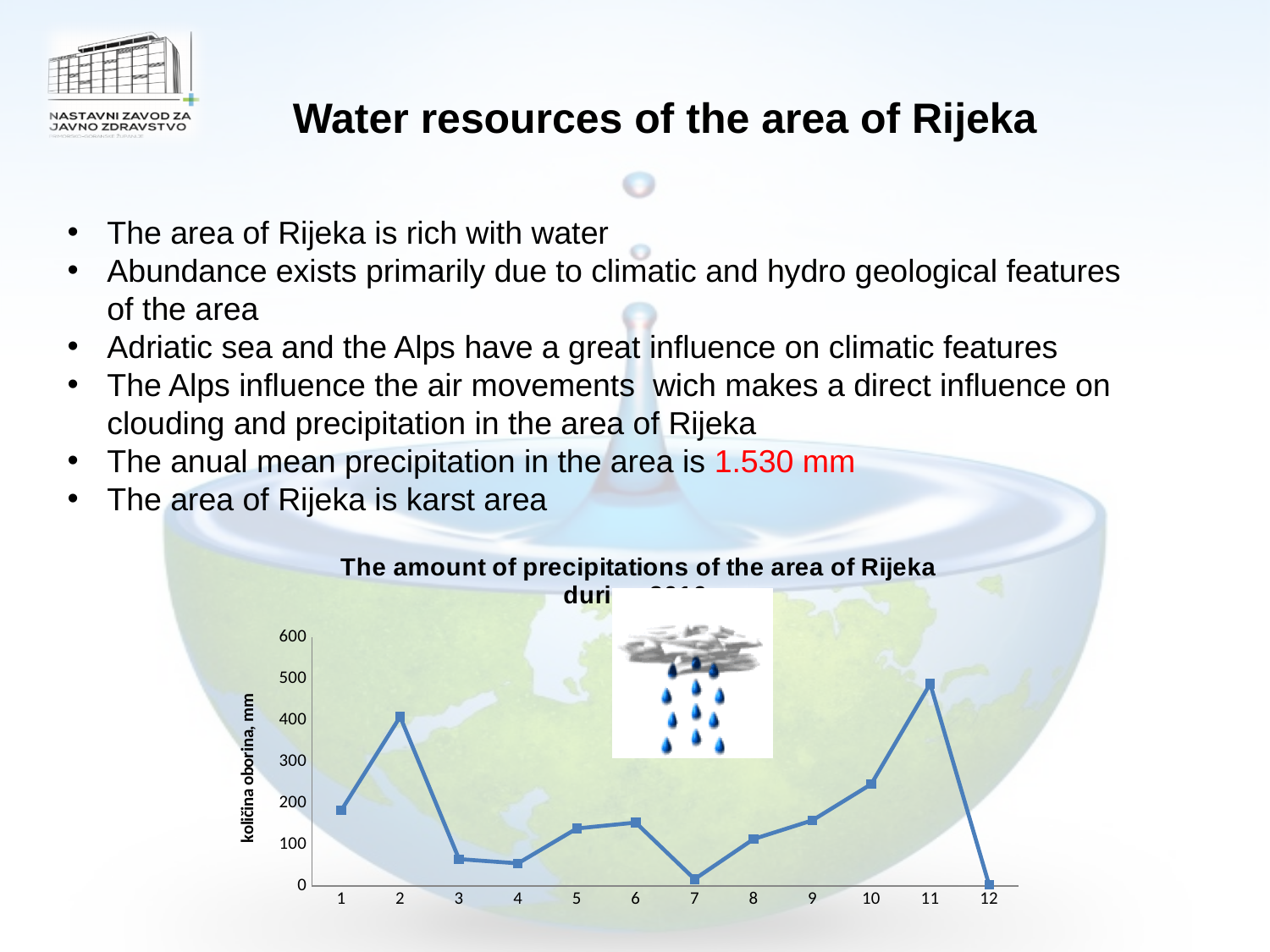
Which has the larger value, month 10 or month 1? month 10 Is the value for month 11 greater or less than 400? greater Is the value for month 2 greater or less than 300? greater How many data points are plotted on the chart? 12 Which month (x-axis category) has the lowest precipitation value? 12 What is the label on the vertical axis of the chart? količina oborina, mm Is the value for month 1 greater or less than 100? greater What kind of chart is shown on the slide? line chart Do the values rise or fall from month 7 to month 11? rise Which month (x-axis category) has the highest precipitation value? 11 Which has the larger value, month 2 or month 3? month 2